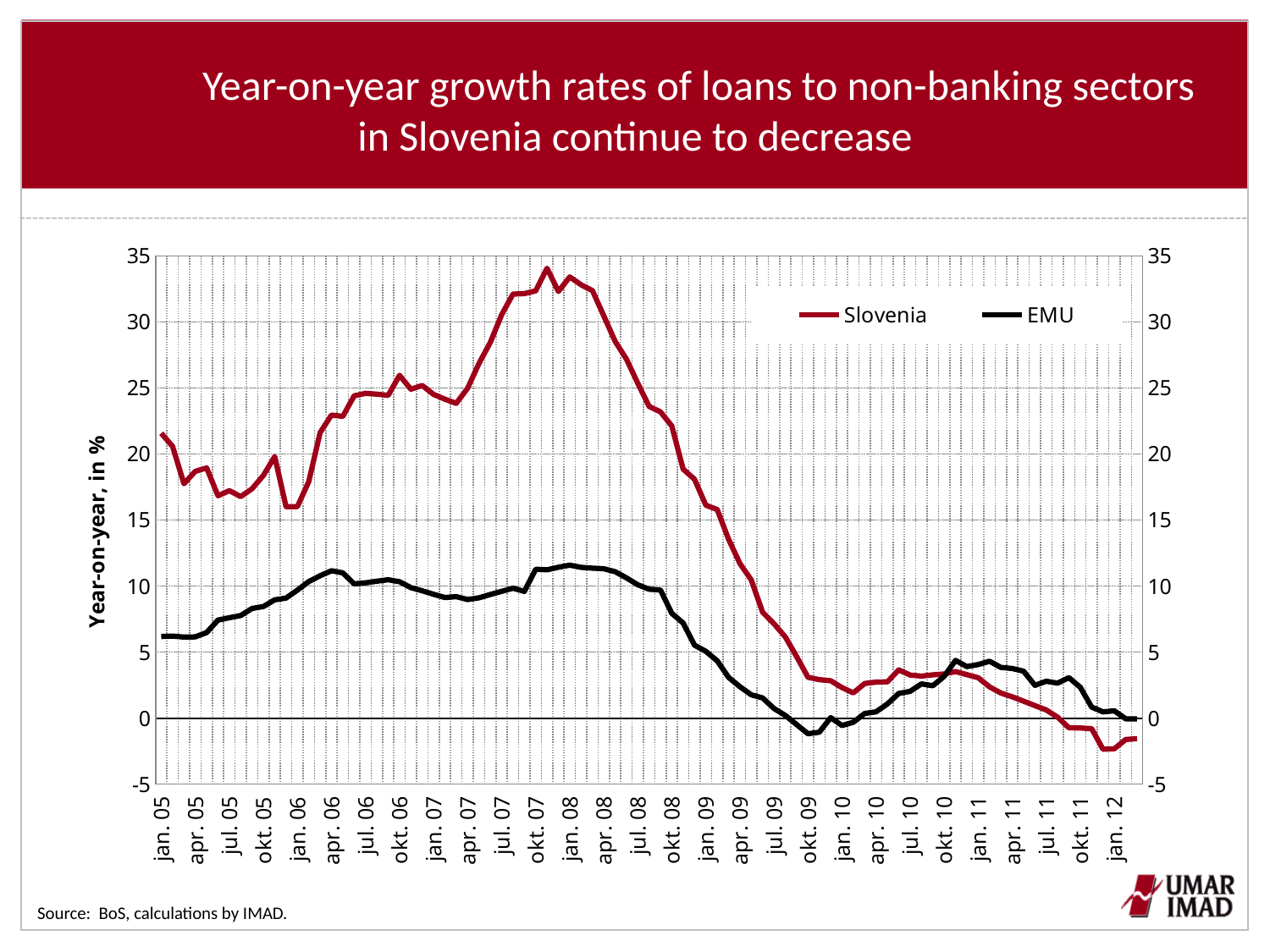
Is the value for EMU at jan. 05 greater or less than 5? greater Is the value for Slovenia at jan. 12 greater or less than 0? less Which two series are listed in the legend? Slovenia and EMU How many series does the legend list? 2 At jan. 12, which series has the larger value, Slovenia or EMU? EMU What kind of chart is shown on the slide? line chart At jan. 08, which series has the larger value, Slovenia or EMU? Slovenia Does the Slovenia series rise or fall between jan. 08 and jan. 10? fall What is the label of the vertical axis? Year-on-year, in % Is the value for EMU at jan. 08 greater or less than 10? greater